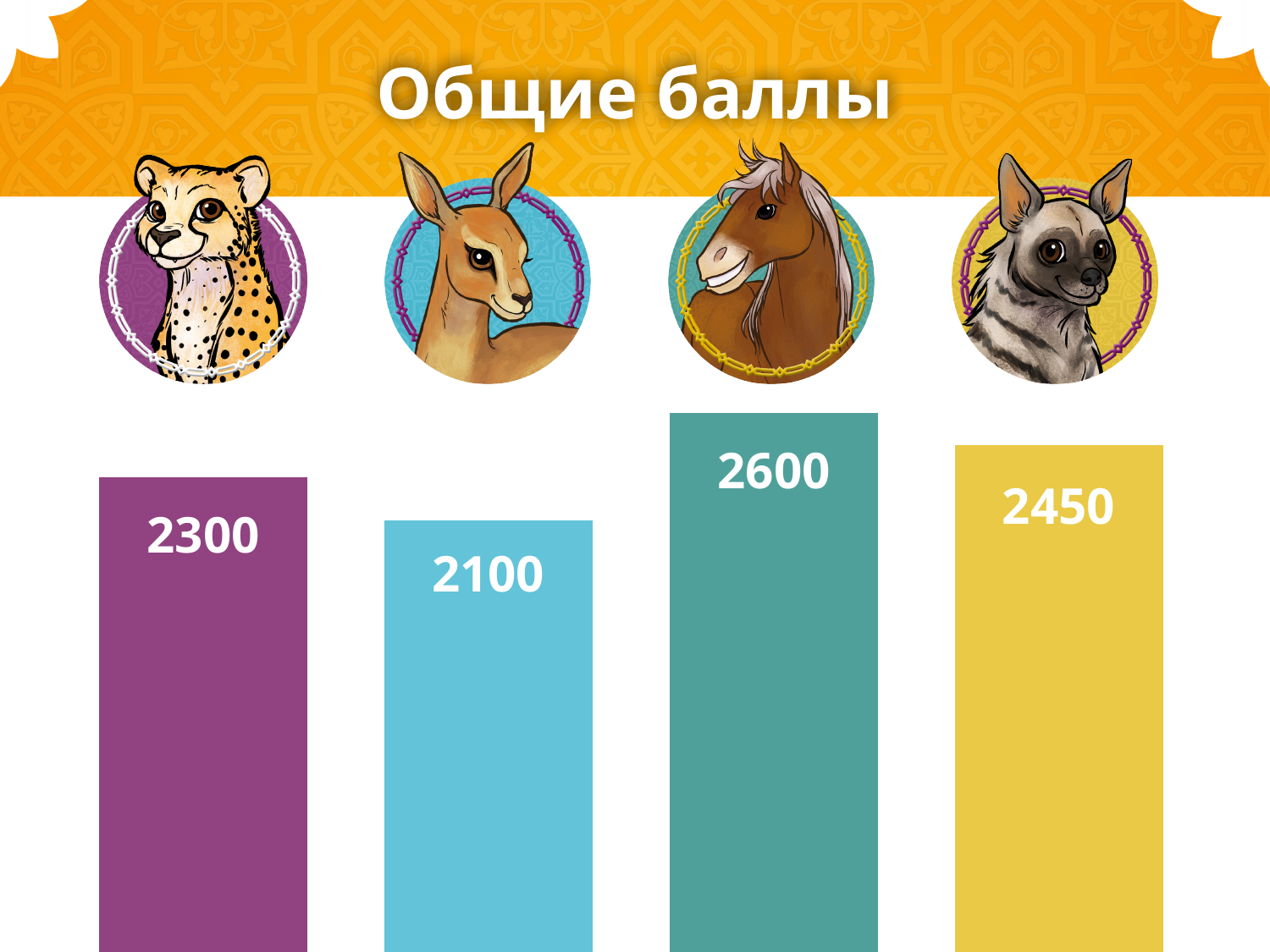
What kind of chart is shown on the slide? Bar chart What is the value shown on the third (teal) bar, under the horse? 2600 What is the value shown on the first (purple) bar, under the cheetah? 2300 What is the value shown on the second (light blue) bar, under the gazelle? 2100 What is the difference between the highest bar (2600) and the lowest bar (2100)? 500 What is the difference between the fourth (yellow) bar and the first (purple) bar? 150 Which bar has the highest value? The third (teal) bar, under the horse, with 2600 How many bars are shown in the chart? 4 Which bar has the lowest value? The second (light blue) bar, under the gazelle, with 2100 What is the title of the chart? Общие баллы Which is larger, the value for the cheetah bar or the value for the hyena bar? The hyena bar (2450) What is the value shown on the fourth (yellow) bar, under the hyena? 2450